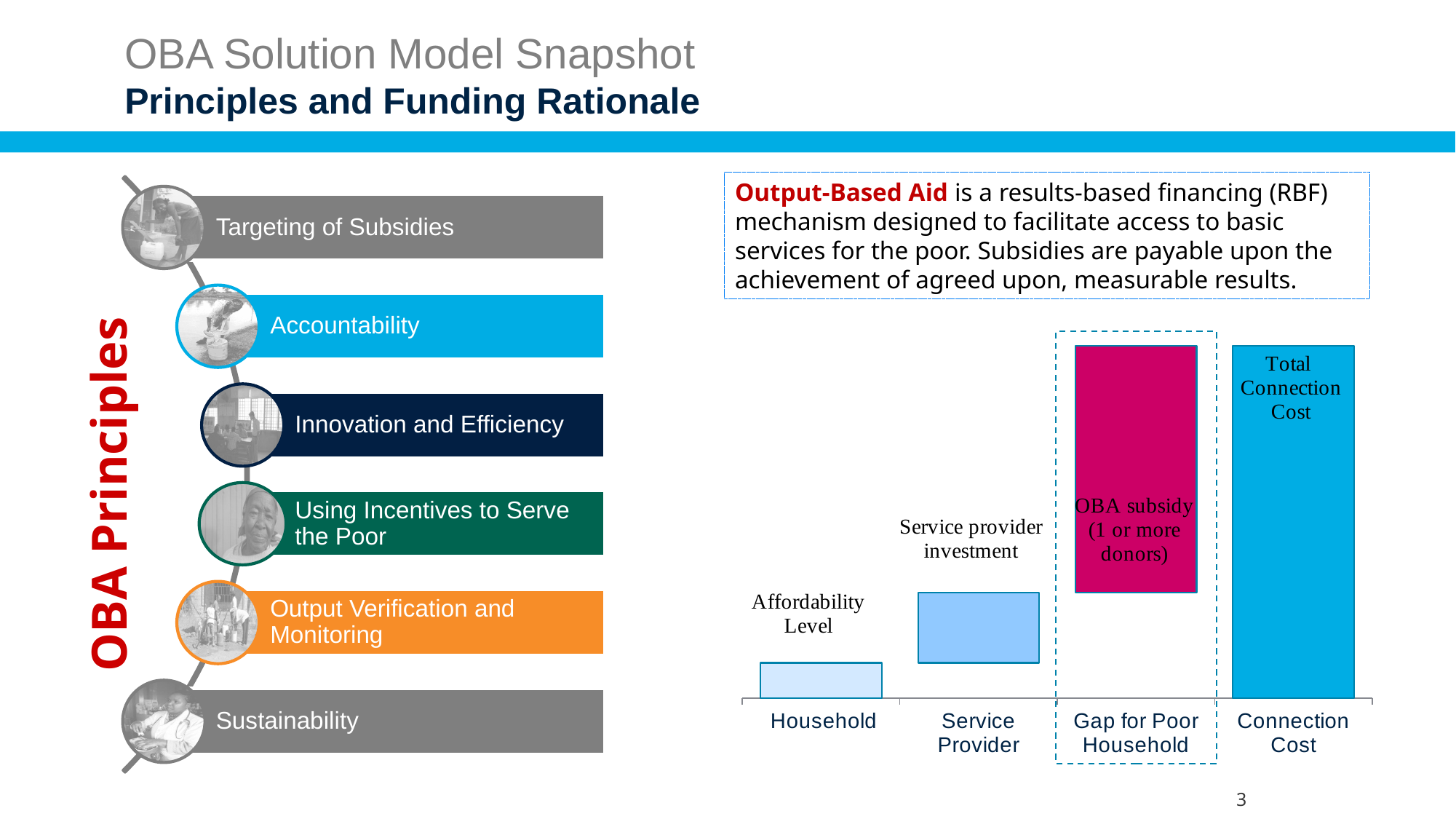
What label is written inside the Gap for Poor Household bar in the chart? OBA subsidy (1 or more donors) How many categories are shown on the x axis of the bar chart? 4 What kind of chart is shown on the right side of the slide? bar chart Which category in the bar chart has the tallest bar? Connection Cost Which category in the bar chart has the shortest bar? Household In the bar chart, which bar is taller: Service Provider or Household? Service Provider What label is written on the Household bar in the chart? Affordability Level In the bar chart, which bar is taller: Gap for Poor Household or Service Provider? Gap for Poor Household In the bar chart, which bar is taller: Connection Cost or Gap for Poor Household? Connection Cost Do the bar heights in the chart generally rise or fall from left to right along the x axis? rise